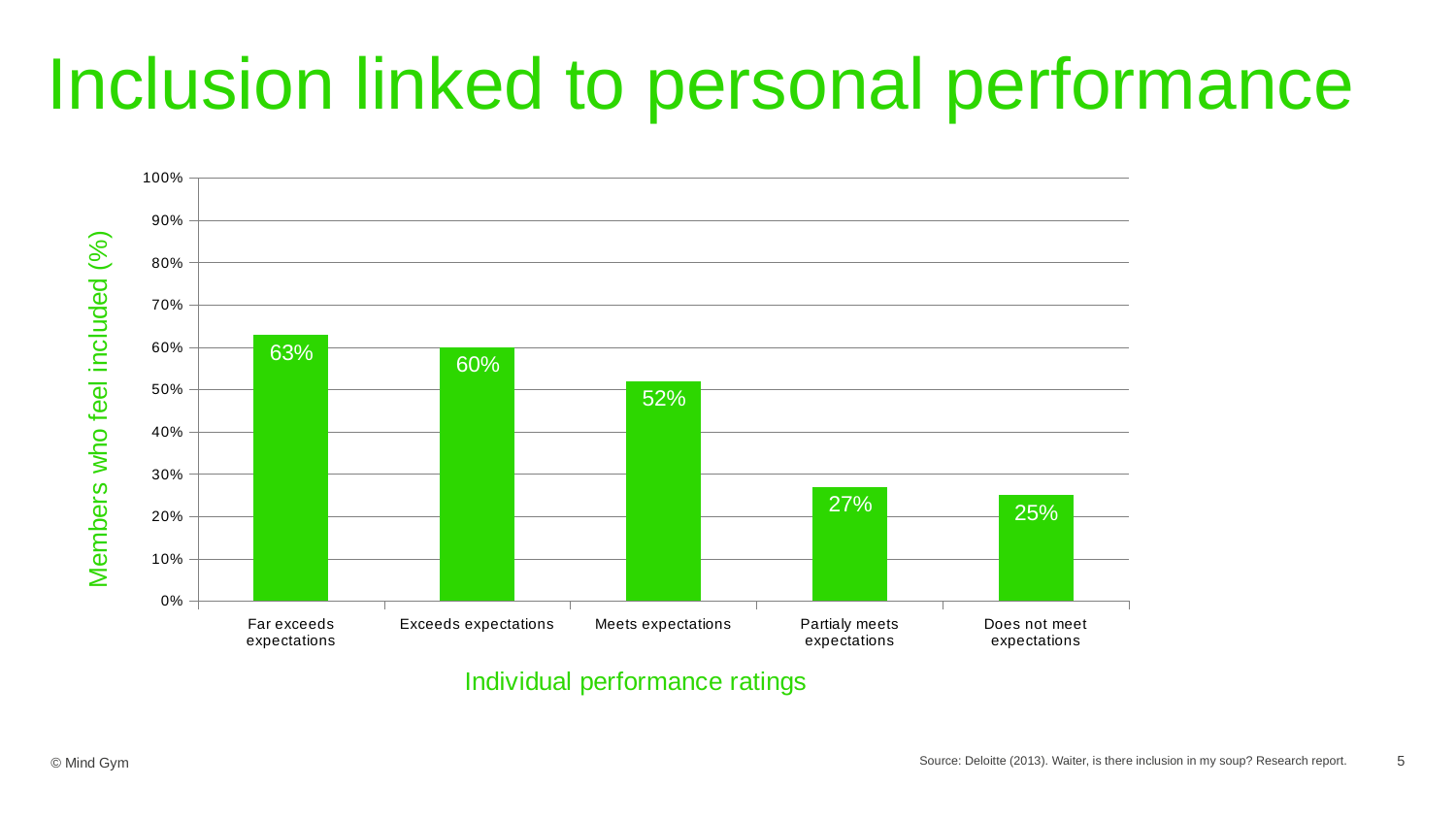
Which is larger, the value for 'Meets expectations' or the value for 'Partialy meets expectations'? Meets expectations Which performance rating has the lowest percentage of members who feel included? Does not meet expectations How many performance rating categories are shown on the chart? 5 Which performance rating has the highest percentage of members who feel included? Far exceeds expectations What is the difference between the values for 'Far exceeds expectations' and 'Does not meet expectations'? 38% What is the label of the x axis? Individual performance ratings What percentage of members who 'Far exceeds expectations' feel included? 63% Is the value for 'Partialy meets expectations' greater or less than 30%? less What is the difference between the values for 'Exceeds expectations' and 'Meets expectations'? 8% What kind of chart is shown on the slide? Bar chart What is the value for 'Meets expectations'? 52% What is the value for 'Does not meet expectations'? 25%